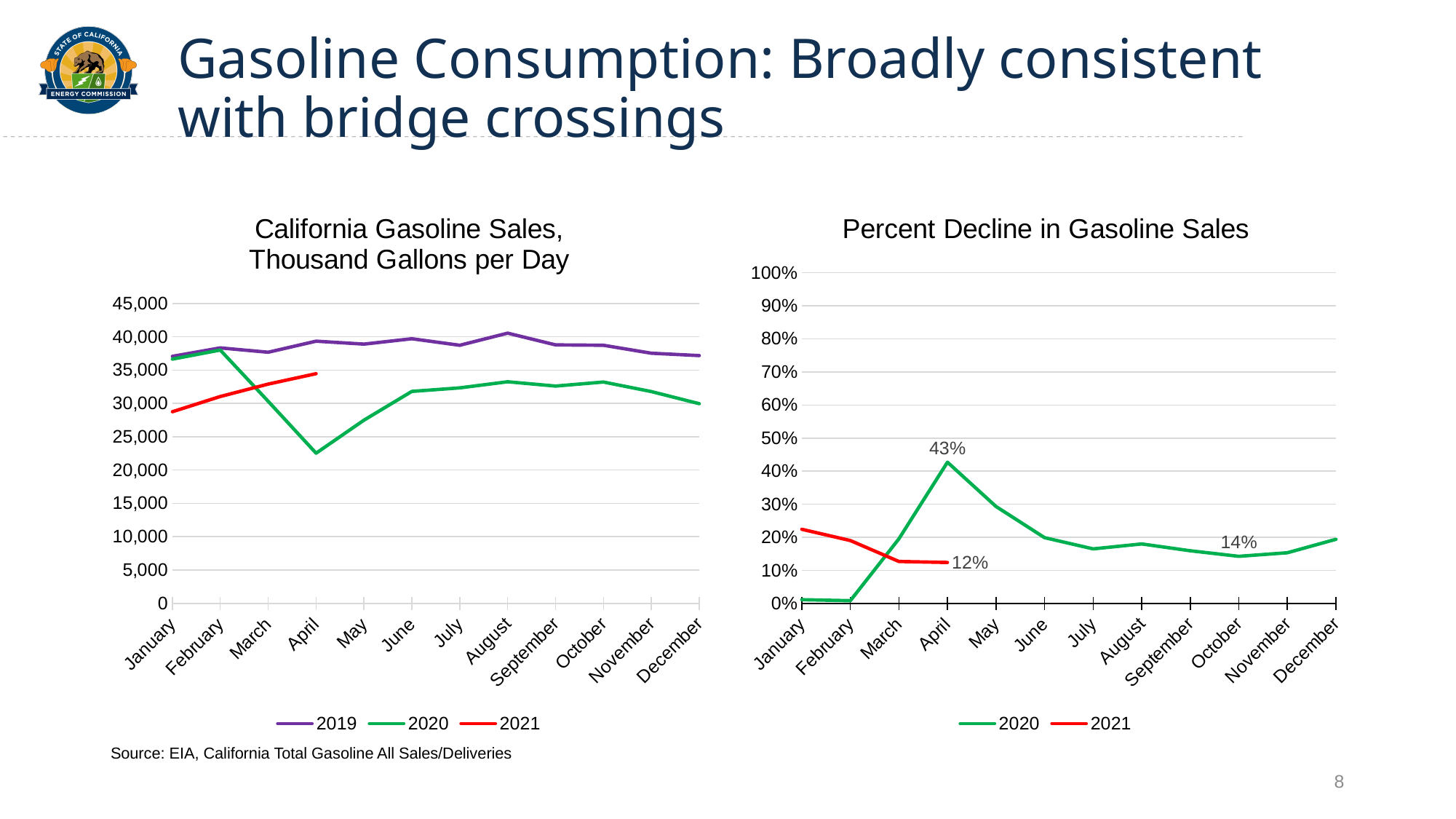
How many series does the legend of the 'California Gasoline Sales, Thousand Gallons per Day' chart list? 3 In the 'Percent Decline in Gasoline Sales' chart, what is the 2020 value for April? 43% In the 'Percent Decline in Gasoline Sales' chart, what is the 2020 value for October? 14% In the 'Percent Decline in Gasoline Sales' chart, what is the 2021 value for April? 12% In the 'California Gasoline Sales, Thousand Gallons per Day' chart, in which month does the 2020 line reach its lowest value? April What kind of chart is the 'California Gasoline Sales, Thousand Gallons per Day' chart? Line chart In the 'Percent Decline in Gasoline Sales' chart, what is the difference between the 2020 and 2021 values for April? 31% In the 'California Gasoline Sales, Thousand Gallons per Day' chart, does the 2021 line rise or fall from January to April? Rise In the 'California Gasoline Sales, Thousand Gallons per Day' chart, is the 2021 value for January greater or less than 30,000? less In the 'California Gasoline Sales, Thousand Gallons per Day' chart, is the 2020 value for April greater or less than 25,000? less In the 'Percent Decline in Gasoline Sales' chart, does the 2021 line rise or fall from January to April? Fall In the 'California Gasoline Sales, Thousand Gallons per Day' chart, which series has the higher value in June, 2019 or 2020? 2019